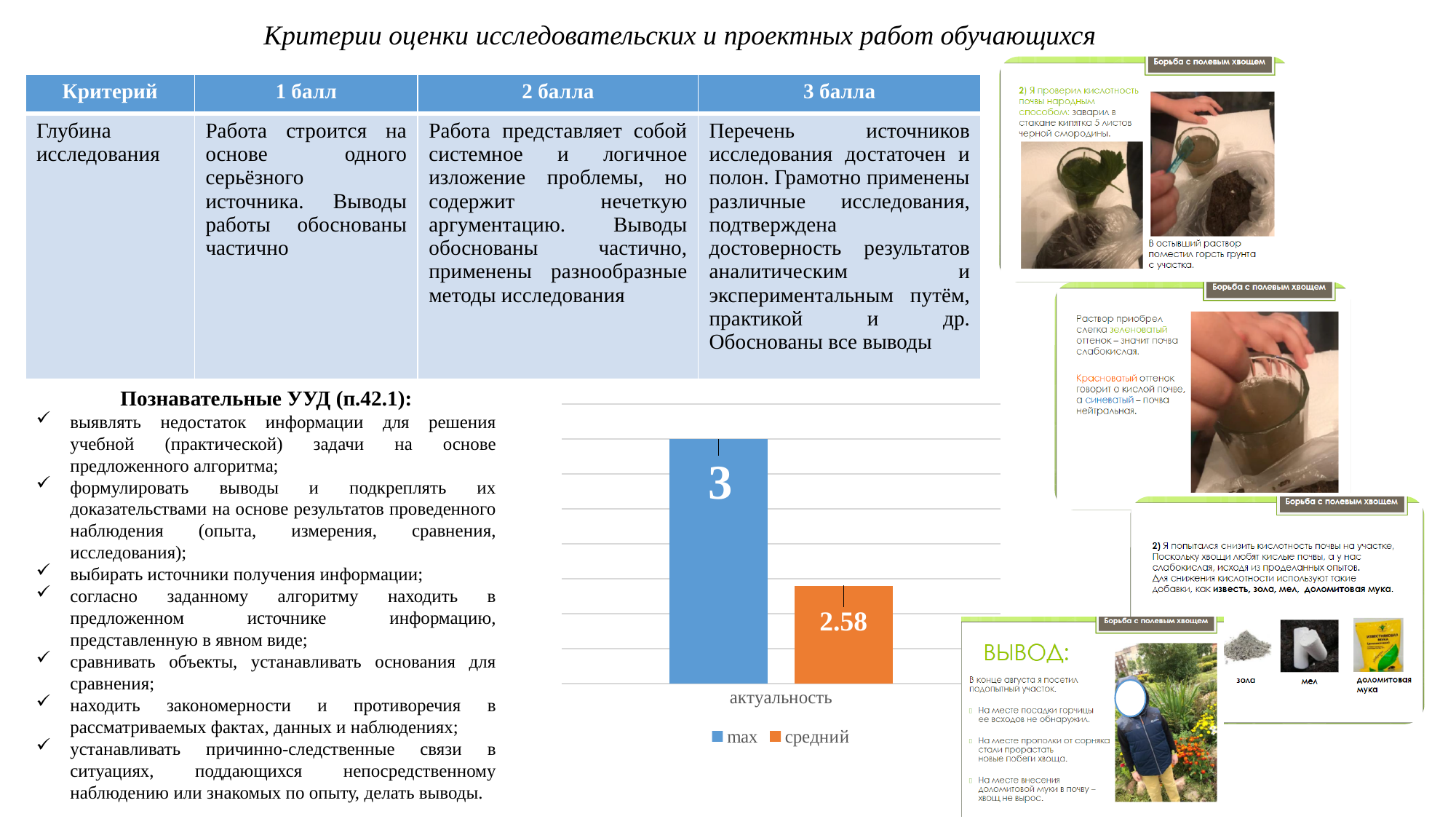
How many categories are shown on the x axis of the chart? 1 What is the category label on the x axis of the chart? актуальность Which series has the lowest value in the chart? средний What colour is the "средний" bar in the chart? orange What is the value of the "средний" bar in the chart? 2.58 What is the value of the "max" bar in the chart? 3 Which series has the higher value in the chart, "max" or "средний"? max What is the difference between the "max" value and the "средний" value in the chart? 0.42 What type of chart is shown on the slide? bar chart How many series does the chart legend list? 2